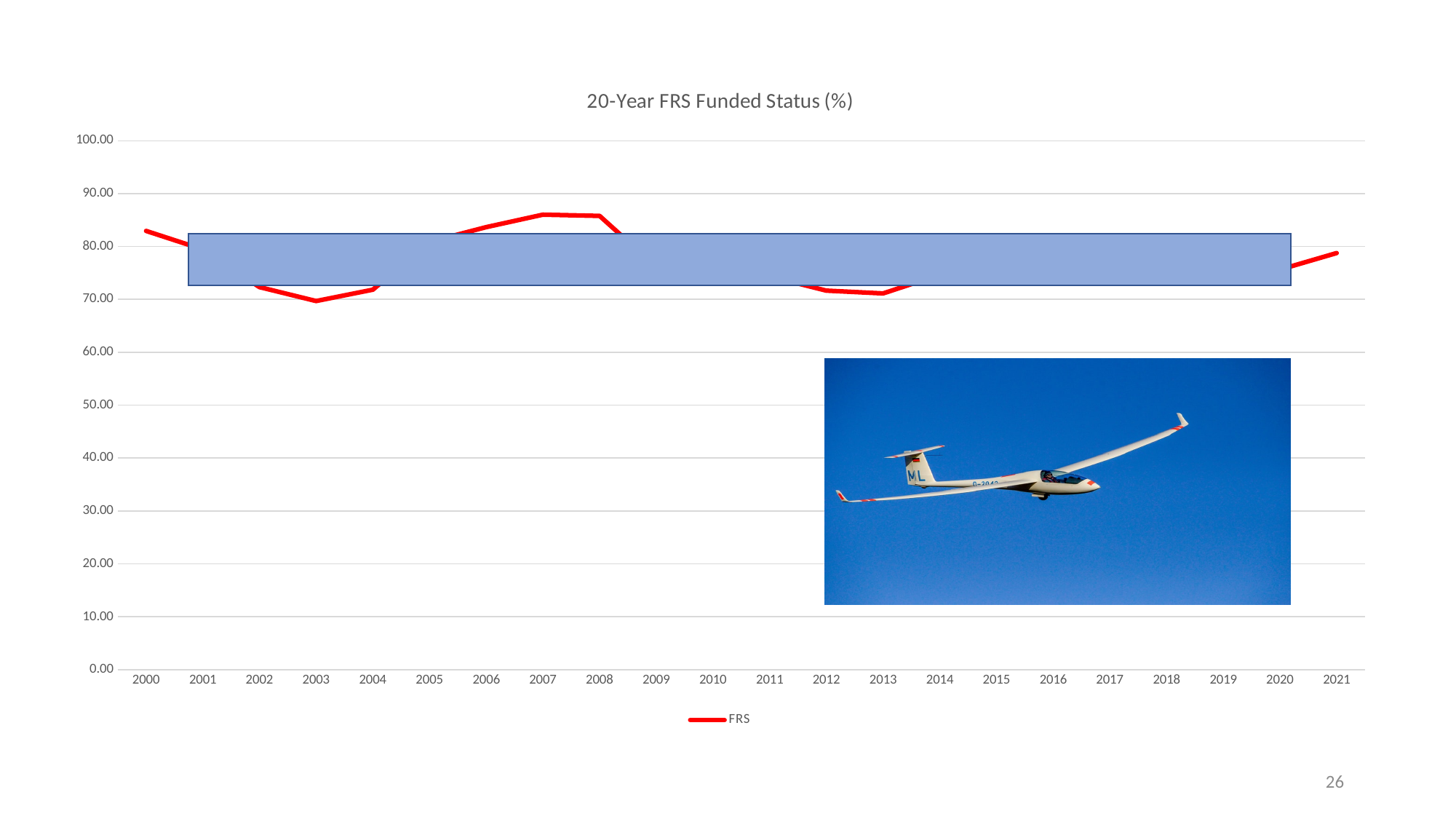
Which year has a larger FRS value, 2007 or 2003? 2007 How many years are shown on the x axis? 22 Does the FRS value rise or fall from 2000 to 2003? fall What kind of chart is shown on the slide? line chart What is the title of the chart? 20-Year FRS Funded Status (%) Which year has the lowest FRS funded status? 2003 What is the name of the series shown in the legend? FRS Is the FRS value for 2013 greater or less than 80.00? less Is the FRS value for 2021 greater or less than 70.00? greater Which year has the highest FRS funded status? 2007 Is the FRS value for 2007 greater or less than 80.00? greater How many series does the legend list? 1